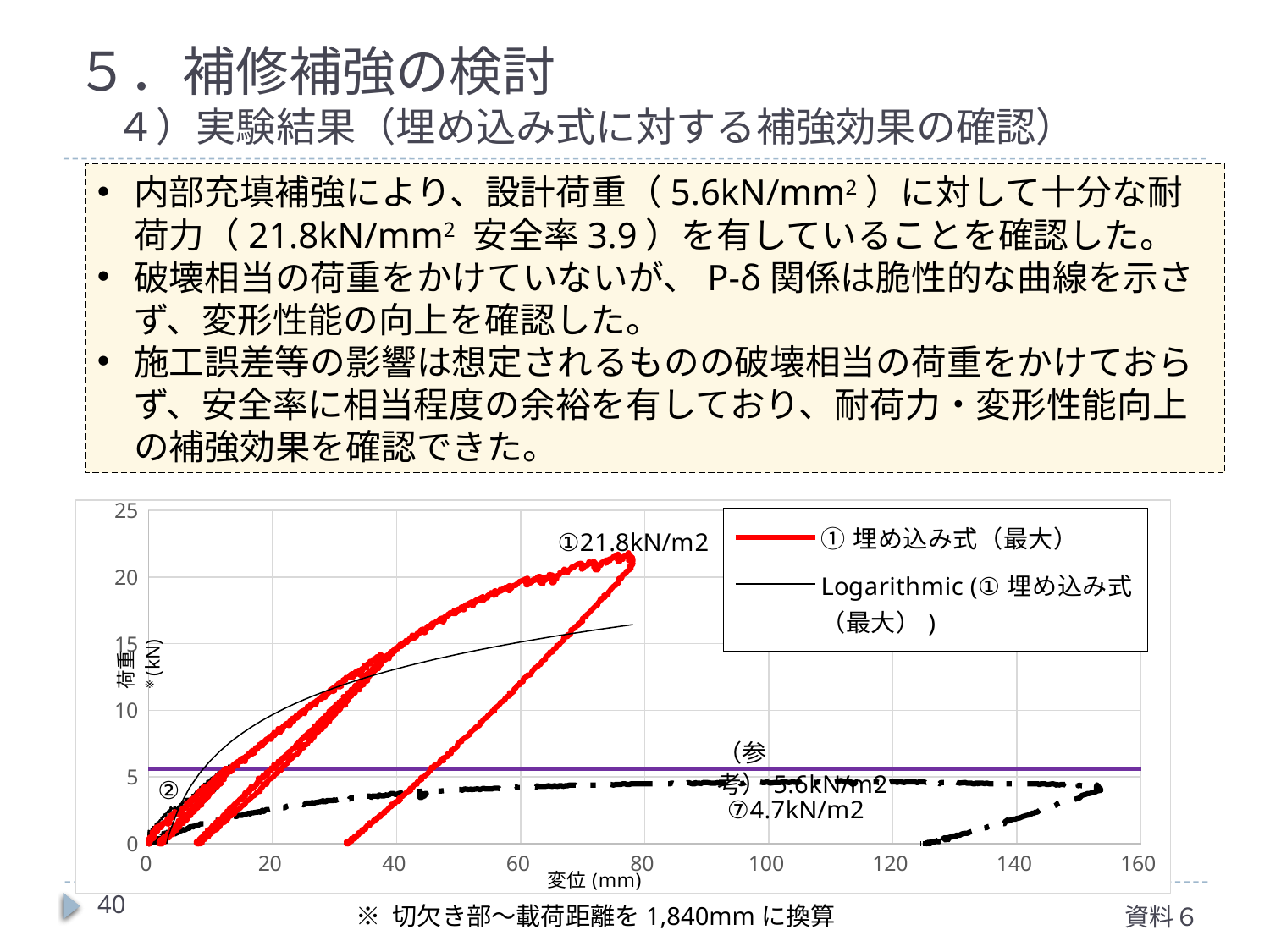
What is the difference between the labelled load of series ① (21.8kN/m2) and the reference line (5.6kN/m2)? 16.2kN/m2 What is the label of the x axis of the chart? 変位 (mm) What maximum load value is labelled for series ① (埋め込み式) on the chart? 21.8kN/m2 What is the difference between the labelled load of series ① (21.8kN/m2) and series ⑦ (4.7kN/m2)? 17.1kN/m2 What value is labelled for series ⑦ on the chart? 4.7kN/m2 Is the value of the purple reference line greater or less than 5 on the load axis? greater Is the value of the dashed ⑦ curve at 100 mm displacement greater or less than 5 kN? less What kind of chart is shown on the slide? line chart Which has the larger labelled load, series ① or series ⑦? series ① What value is labelled for the reference (参考) horizontal line on the chart? 5.6kN/m2 Does the Logarithmic trendline rise or fall as displacement increases? rise How many series does the chart legend list? 2